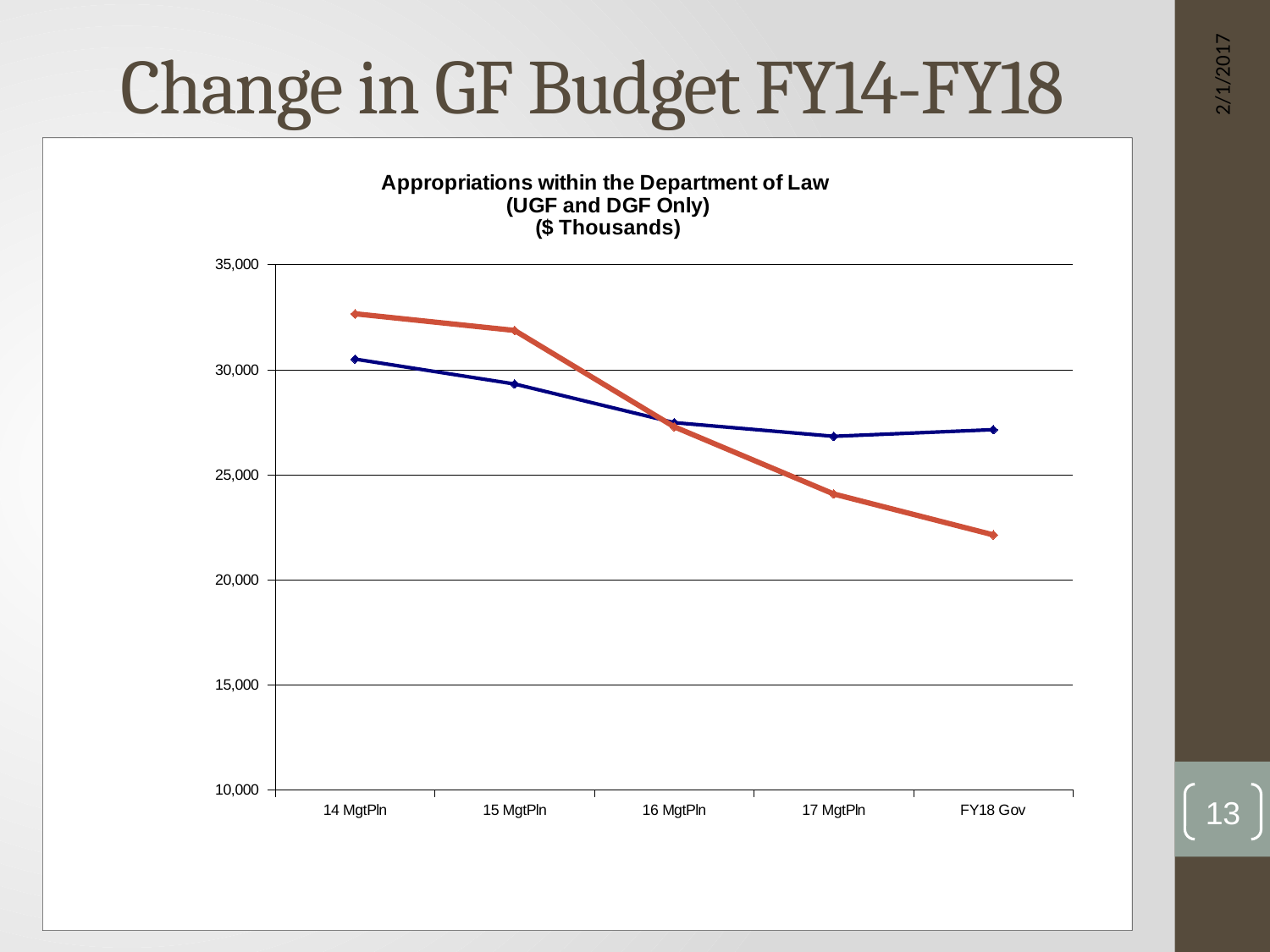
Does the red line rise or fall from 14 MgtPln to FY18 Gov? fall Is the value of the red line at 14 MgtPln greater or less than 30,000? greater Is the value of the blue line at FY18 Gov greater or less than 30,000? less How many categories are shown along the x axis of the chart? 5 What is the title of the chart? Appropriations within the Department of Law (UGF and DGF Only) ($ Thousands) How many lines are plotted on the chart? 2 Is the value of the blue line at 17 MgtPln greater or less than 25,000? greater At FY18 Gov, which line has the higher value, the red line or the blue line? the blue line What is the first category on the x axis of the chart? 14 MgtPln What type of chart is shown on the slide? line chart At 14 MgtPln, which line has the higher value, the red line or the blue line? the red line